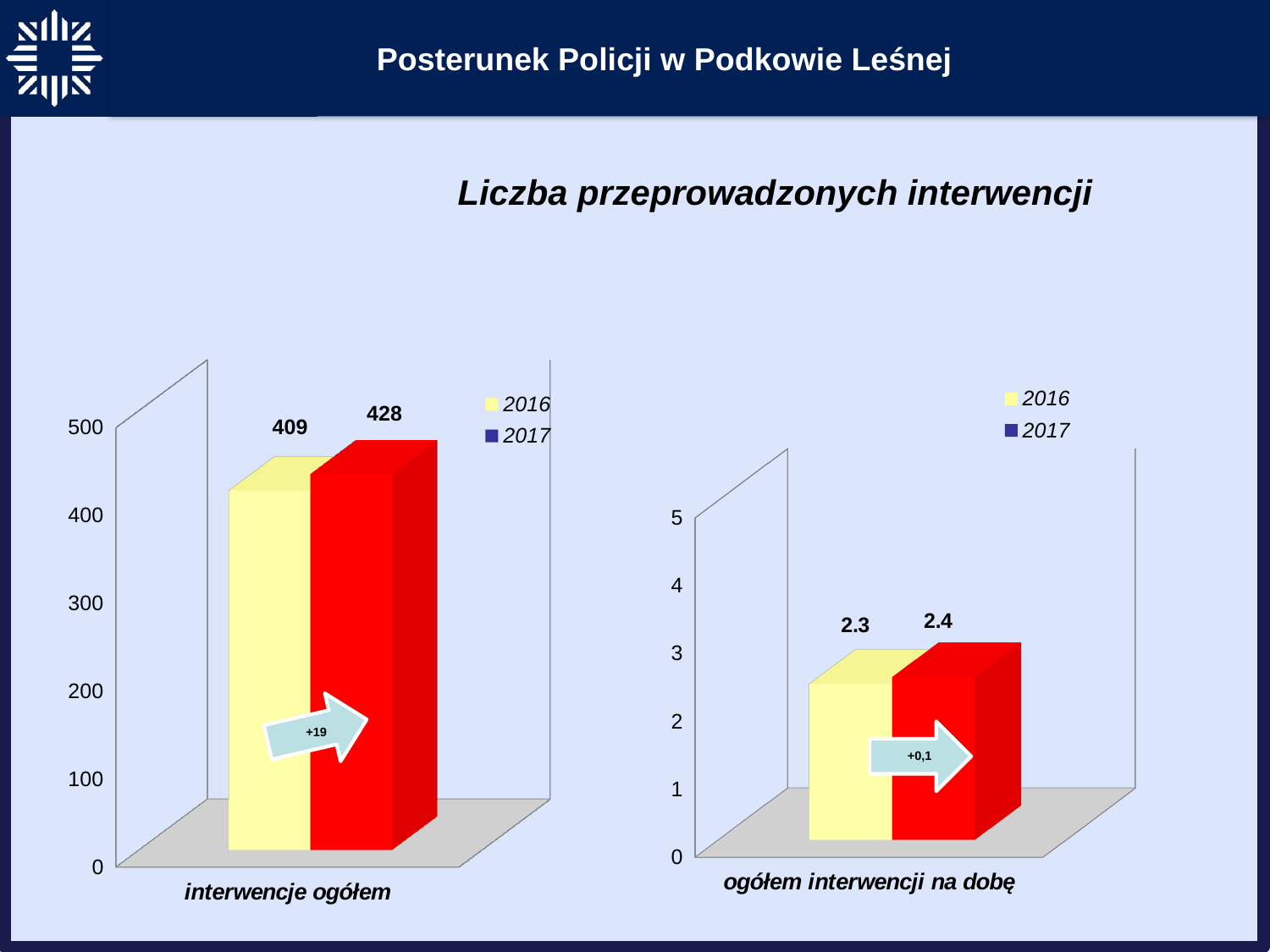
In the left chart (interwencje ogółem), what is the difference between the 2017 and 2016 values? 19 In the left chart (interwencje ogółem), what is the value for 2016? 409 In the left chart (interwencje ogółem), which year has the higher value, 2016 or 2017? 2017 In the right chart (ogółem interwencji na dobę), what is the value for 2016? 2.3 What kind of chart is the right chart (ogółem interwencji na dobę)? bar chart In the left chart (interwencje ogółem), what is the value for 2017? 428 In the right chart (ogółem interwencji na dobę), what is the value for 2017? 2.4 In the right chart (ogółem interwencji na dobę), which year has the lower value? 2016 In the left chart (interwencje ogółem), is the value for 2016 greater or less than 400? greater How many series does the legend of the left chart (interwencje ogółem) list? 2 What is the title shown above the charts on the slide? Liczba przeprowadzonych interwencji In the right chart (ogółem interwencji na dobę), is the value for 2017 greater or less than 3? less